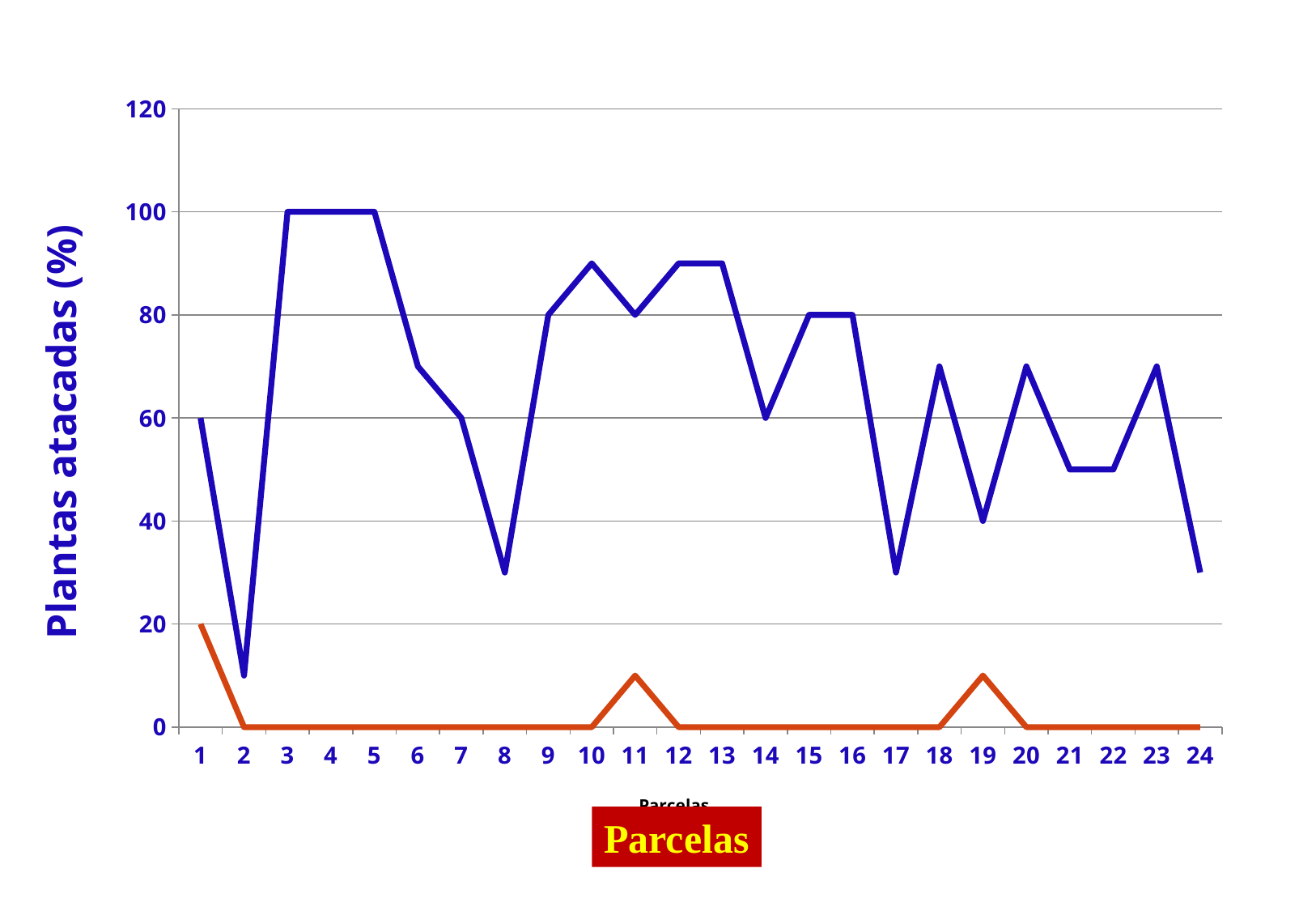
What kind of chart is shown on the slide? line chart What is the title of the y axis? Plantas atacadas (%) Is the value of the blue line at parcela 8 greater or less than 40? less What is the value of the orange line at parcela 5? 0 On the blue line, which has the larger value: parcela 9 or parcela 17? parcela 9 What is the highest value reached by the blue line? 100 What is the value of the orange line at parcela 1? 20 What is the difference between the blue line's value at parcela 3 and at parcela 1? 40 How many parcelas are shown along the x axis? 24 What is the value of the blue line at parcela 3? 100 What is the value of the blue line at parcela 1? 60 Is the value of the blue line at parcela 10 greater or less than 80? greater